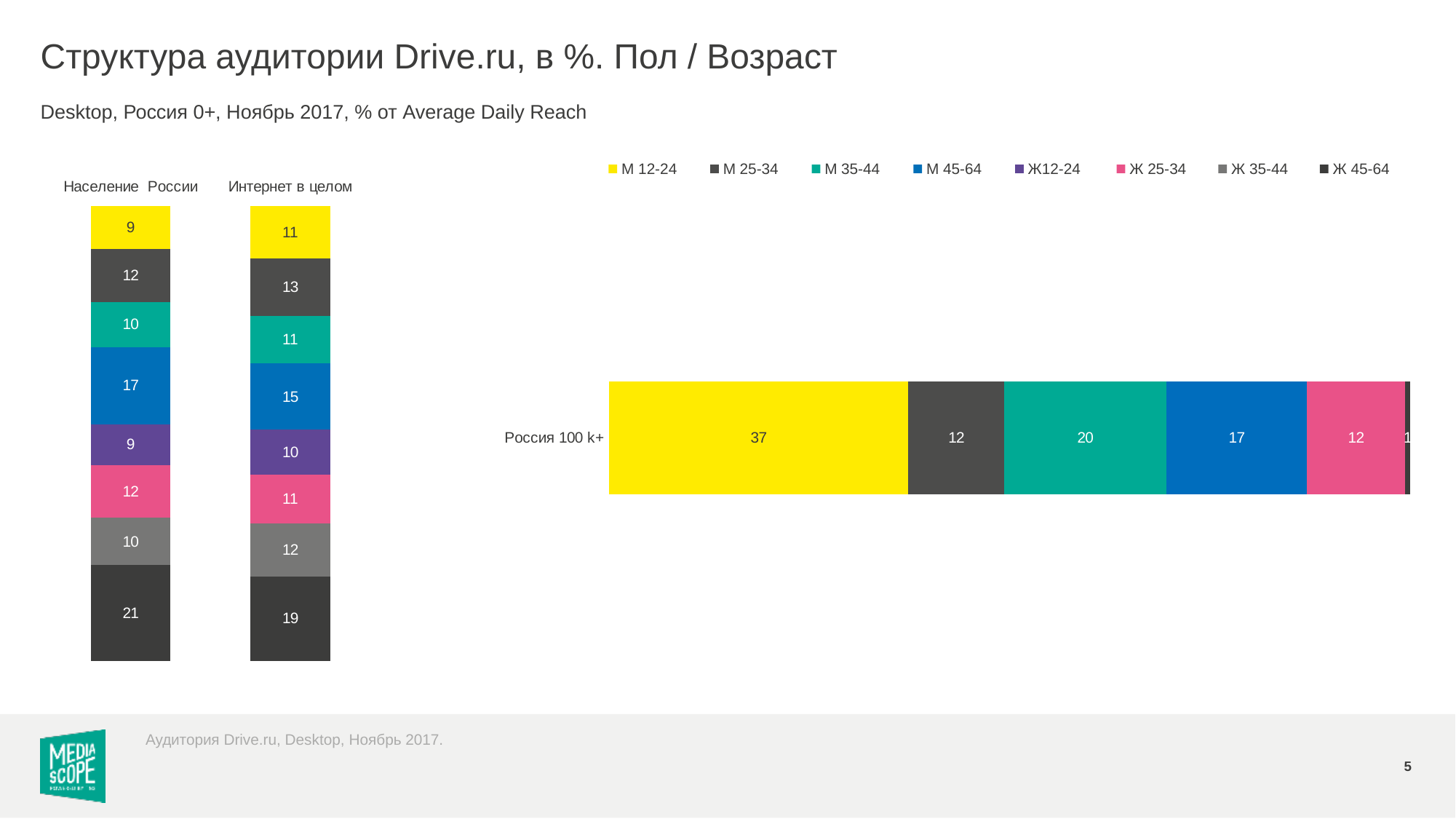
In the "Россия 100 k+" bar, what is the value for М 12-24? 37 In the "Интернет в целом" bar, what is the value for М 25-34? 13 What is the difference between the Ж 45-64 values in the "Население России" bar and the "Интернет в целом" bar? 2 What kind of chart is the "Россия 100 k+" chart? Stacked bar chart In the "Население России" bar, what is the value for Ж 45-64? 21 In the "Население России" bar, which segment is the largest? Ж 45-64 In the "Население России" bar, what is the value for М 45-64? 17 In the "Россия 100 k+" bar, what is the value for М 35-44? 20 In the "Россия 100 k+" bar, what is the difference between М 12-24 and М 35-44? 17 In the "Россия 100 k+" bar, which segment is the largest? М 12-24 How many series does the legend list? 8 Which is larger: М 45-64 in the "Население России" bar or М 45-64 in the "Интернет в целом" bar? Население России